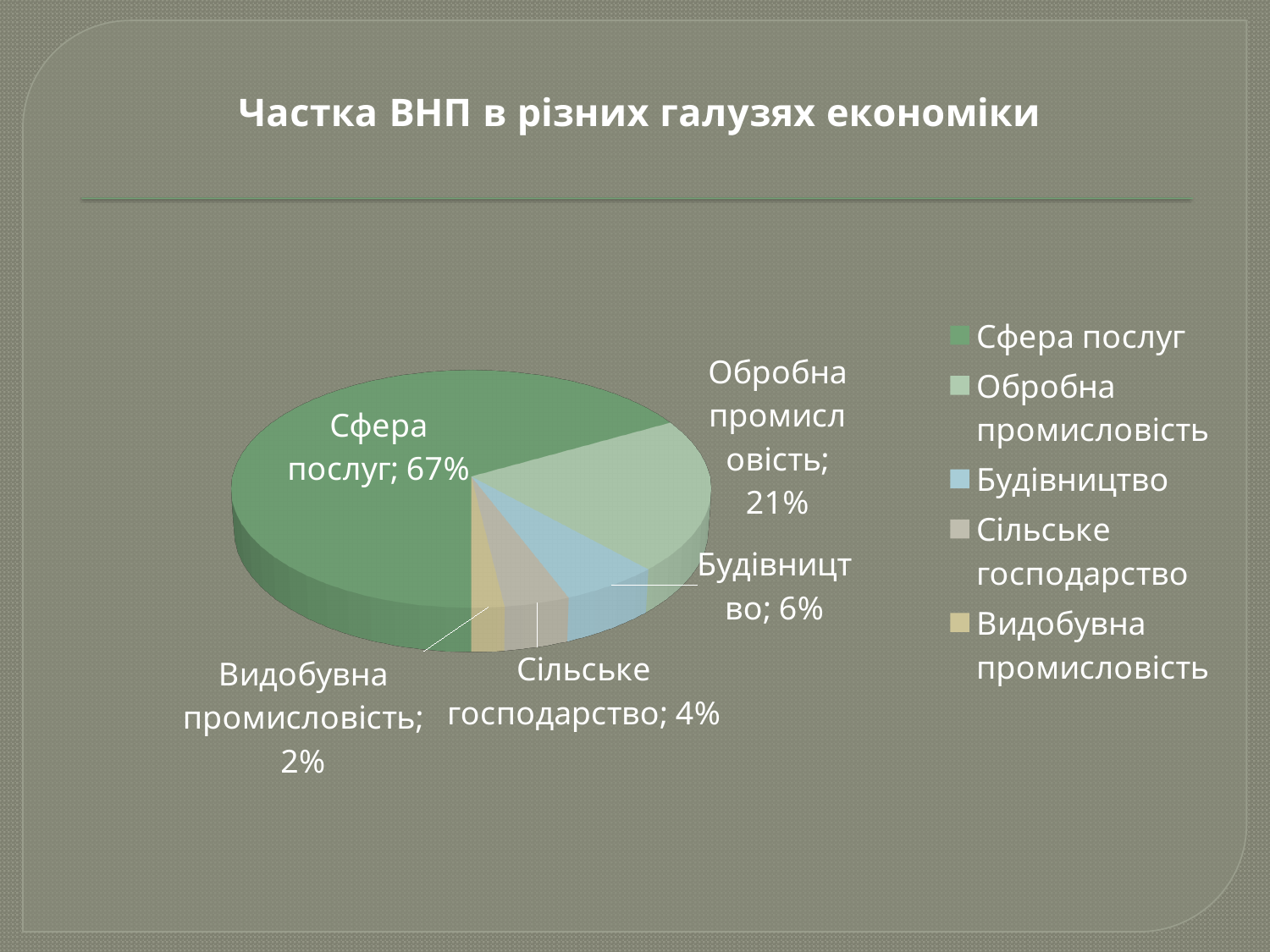
What share does Будівництво have in the pie chart? 6% Which category has the largest share of the pie? Сфера послуг What is the title of the chart? Частка ВНП в різних галузях економіки What share does Сфера послуг have in the pie chart? 67% Which is larger, the share of Будівництво or the share of Сільське господарство? Будівництво Which category has the smallest share of the pie? Видобувна промисловість What share does Сільське господарство have in the pie chart? 4% What kind of chart is shown on the slide? Pie chart What share does Видобувна промисловість have in the pie chart? 2% What is the difference between the shares of Сфера послуг and Обробна промисловість? 46% How many categories are shown in the pie chart? 5 What share does Обробна промисловість have in the pie chart? 21%